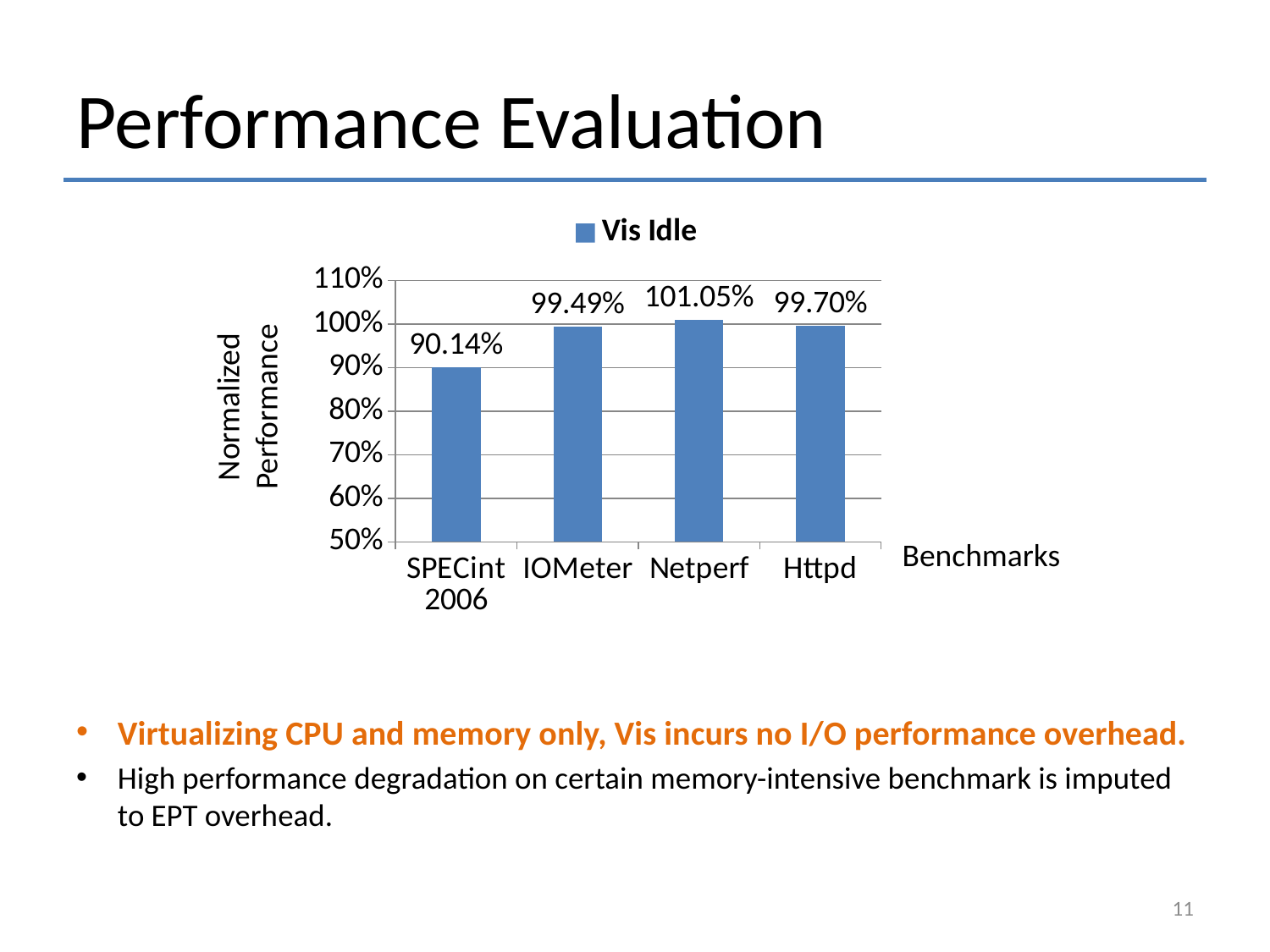
Which benchmark has the lowest normalized performance? SPECint 2006 What is the difference between the normalized performance of Netperf and SPECint 2006? 10.91% How many benchmarks are shown on the x axis? 4 Which has a higher normalized performance, IOMeter or SPECint 2006? IOMeter What is the normalized performance for IOMeter? 99.49% What is the normalized performance for SPECint 2006? 90.14% What is the normalized performance for Httpd? 99.70% Which benchmark has the highest normalized performance? Netperf What series name does the legend show? Vis Idle What is the normalized performance for Netperf? 101.05% Is the value for SPECint 2006 greater or less than 100%? less What type of chart is shown on the slide? bar chart